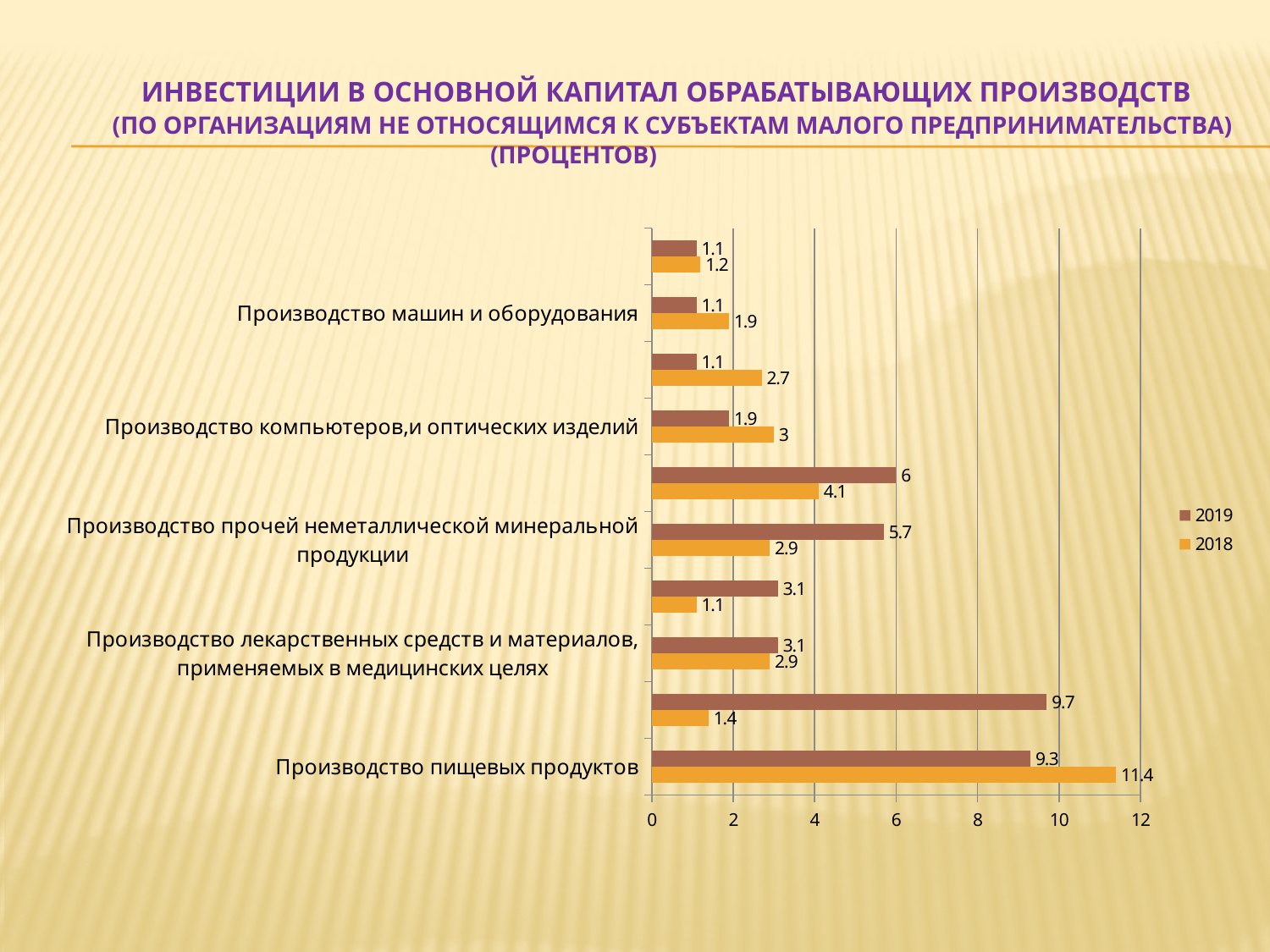
For Производство прочей неметаллической минеральной продукции, which year has the larger value, 2019 or 2018? 2019 What kind of chart is shown on the slide? bar chart What is the 2018 value for Производство компьютеров, и оптических изделий? 3 What is the 2019 value for Производство пищевых продуктов? 9.3 What is the 2018 value for Производство пищевых продуктов? 11.4 Which labeled category has the highest 2018 value? Производство пищевых продуктов What is the 2018 value for Производство машин и оборудования? 1.9 What is the difference between the 2019 and 2018 values for Производство лекарственных средств и материалов, применяемых в медицинских целях? 0.2 What are the series listed in the legend? 2019 and 2018 What is the difference between the 2018 and 2019 values for Производство пищевых продуктов? 2.1 How many series does the legend list? 2 What is the 2019 value for Производство прочей неметаллической минеральной продукции? 5.7